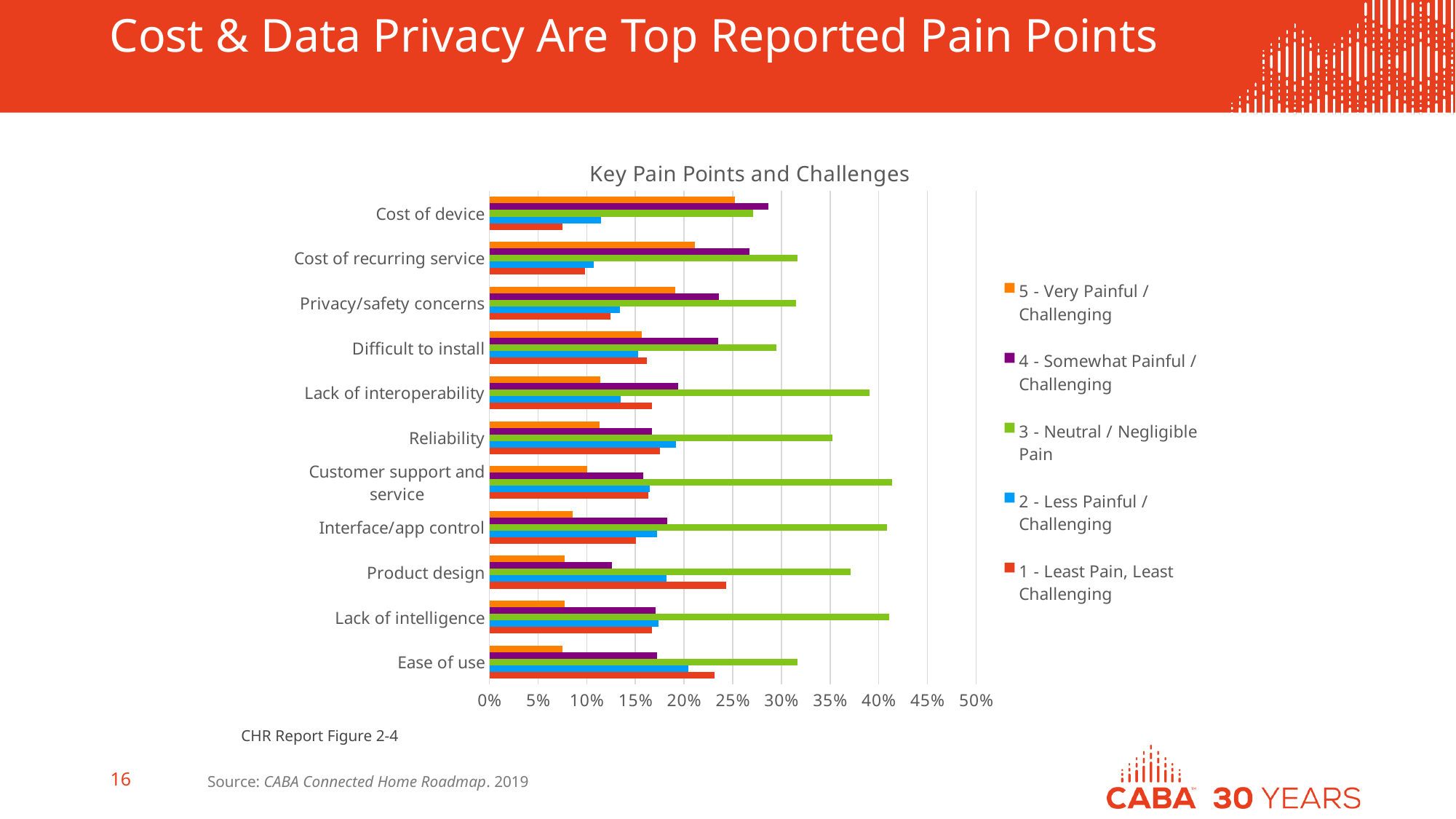
Is the '3 - Neutral / Negligible Pain' value for Lack of interoperability greater or less than 35%? greater How many pain point categories are listed on the chart? 11 Which colour represents the '3 - Neutral / Negligible Pain' series? green Is the '1 - Least Pain, Least Challenging' value for Ease of use greater or less than 20%? greater Which category has the highest value for the '5 - Very Painful / Challenging' series? Cost of device Is the '3 - Neutral / Negligible Pain' value for Reliability greater or less than 30%? greater Which has the larger '5 - Very Painful / Challenging' value, Cost of device or Ease of use? Cost of device What kind of chart is shown on the slide? bar chart What is the title of the chart? Key Pain Points and Challenges How many series does the legend list? 5